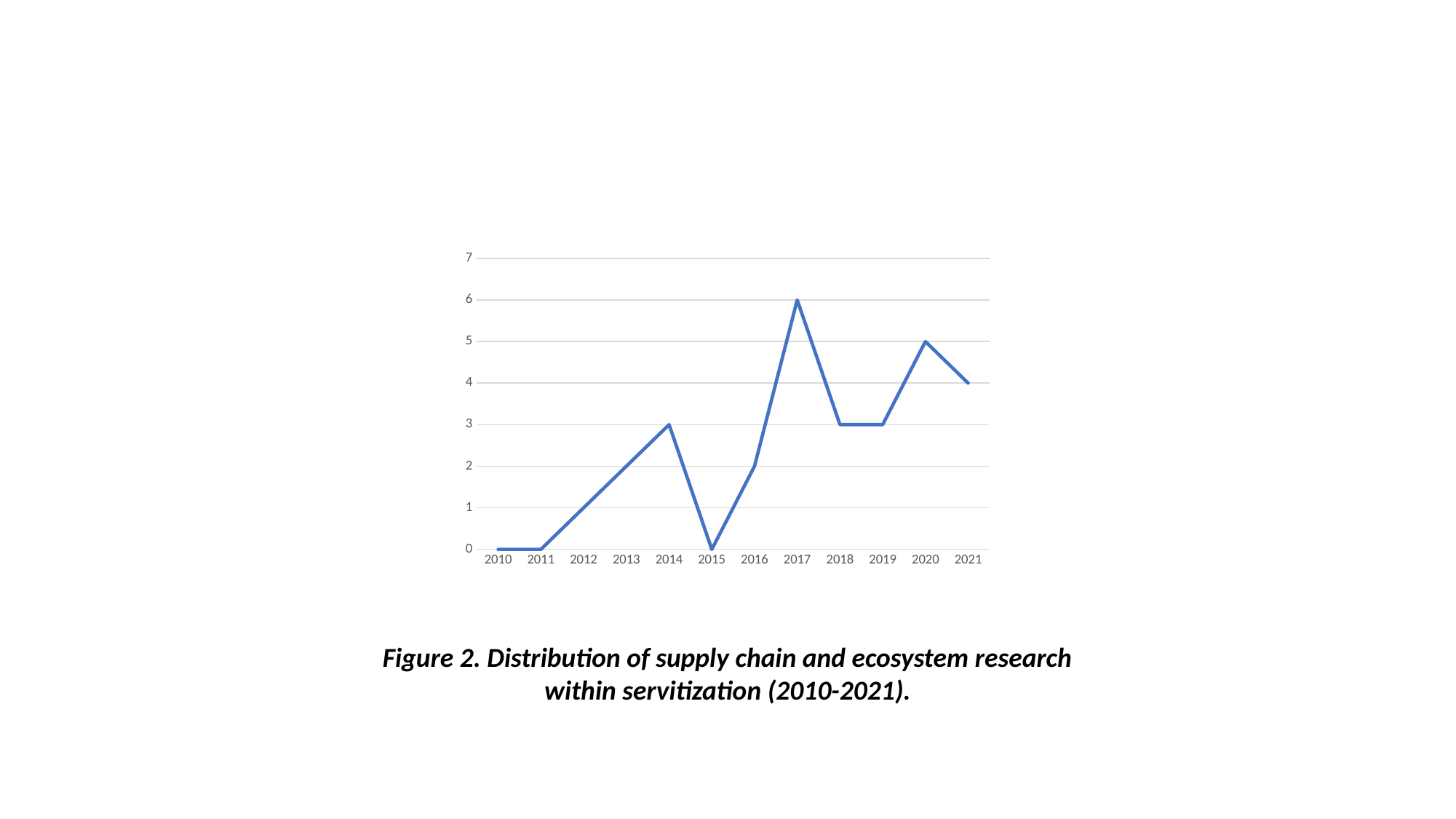
What is the value for 2017? 6 What is the difference between the values for 2017 and 2018? 3 Is the value for 2016 greater or less than 3? less What is the value for 2020? 5 Which year has the larger value, 2020 or 2021? 2020 What is the value for 2015? 0 What kind of chart is shown on the slide? line chart What is the value for 2021? 4 What is the value for 2014? 3 How many years are shown on the x axis? 12 Which year has the highest value? 2017 Does the value rise or fall from 2017 to 2018? fall